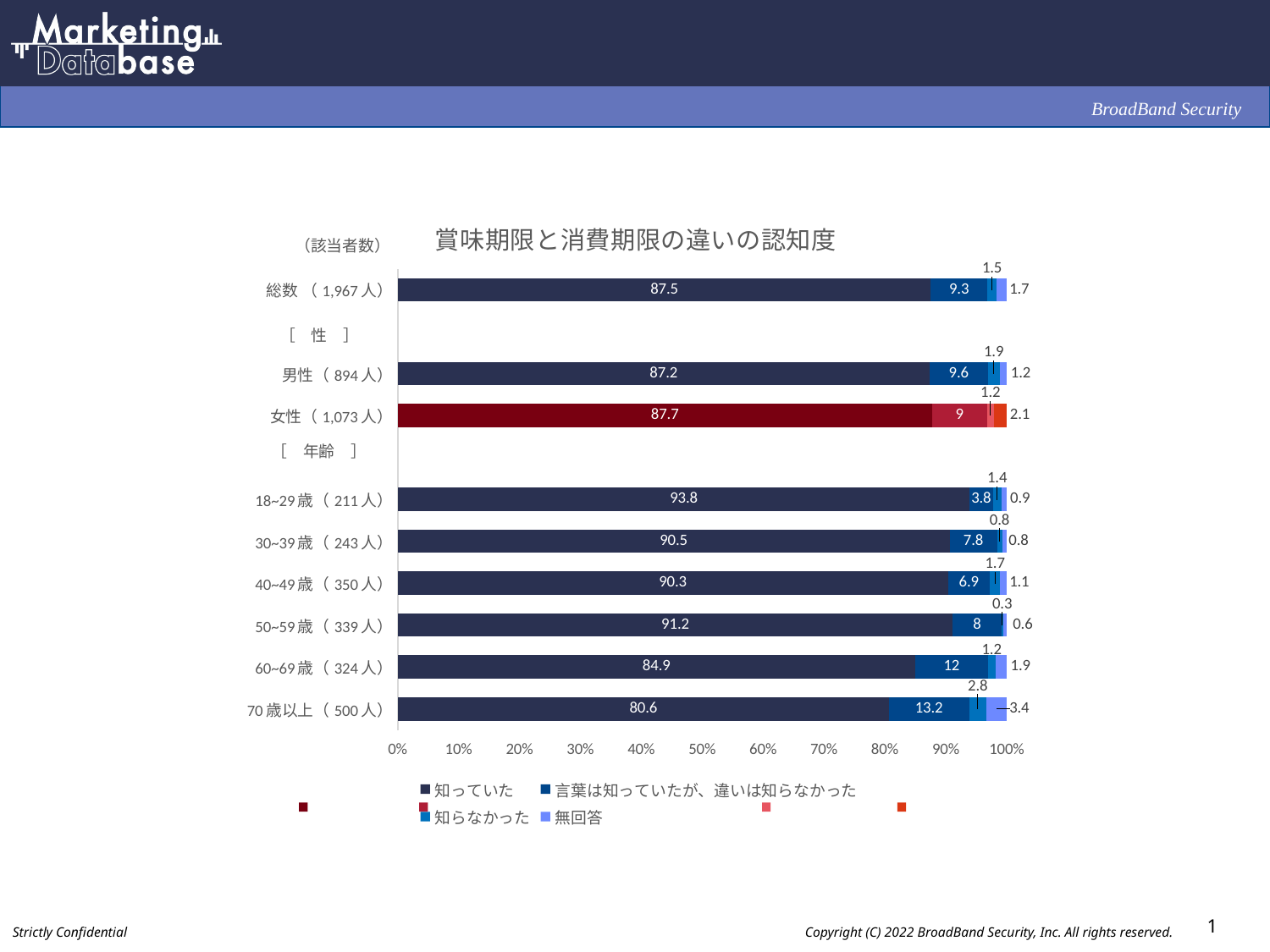
How many series does the legend list? 4 What is the value of 知っていた for 総数 (1,967人)? 87.5 What is the value of 知らなかった for 50~59歳 (339人)? 0.3 What is the title of the chart? 賞味期限と消費期限の違いの認知度 What is the value of 無回答 for 女性 (1,073人)? 2.1 Which is larger, the 言葉は知っていたが、違いは知らなかった value for 60~69歳 (324人) or for 40~49歳 (350人)? 60~69歳 (324人) Which category has the highest value for 知っていた? 18~29歳 (211人) What kind of chart is shown on the slide? Stacked bar chart What is the value of 言葉は知っていたが、違いは知らなかった for 70歳以上 (500人)? 13.2 Which category has the lowest value for 知っていた? 70歳以上 (500人) How many categories (bars) are plotted in the chart? 9 What is the difference between the 知っていた values for 18~29歳 (211人) and 70歳以上 (500人)? 13.2